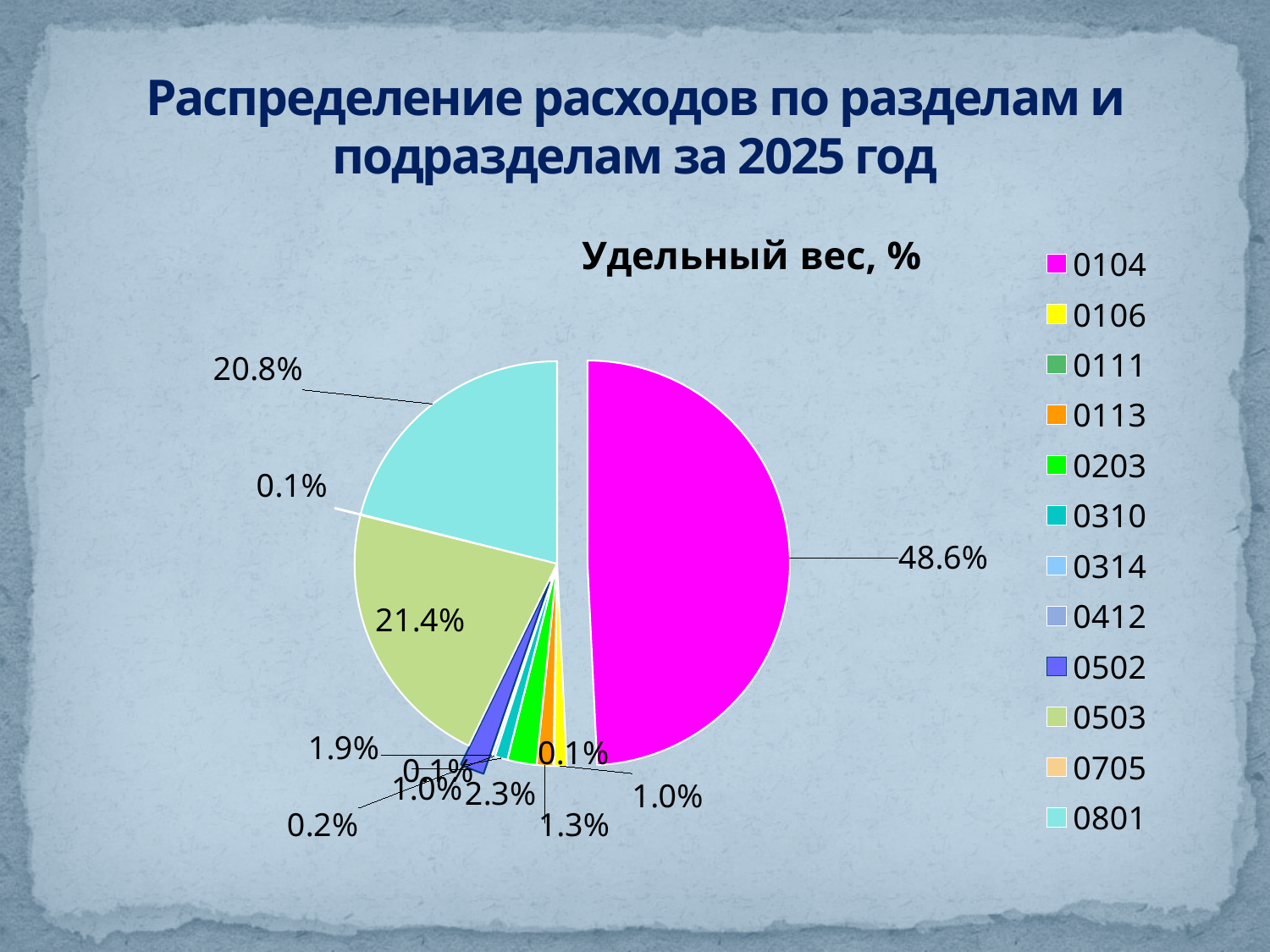
How many entries does the chart legend list? 12 What kind of chart is shown on the slide? pie chart What share of the pie does category 0104 have? 48.6% Which category has the largest slice of the pie? 0104 What is the difference between the shares of 0104 and 0503? 27.2% What share of the pie does category 0801 have? 20.8% What is the difference between the shares of 0503 and 0801? 0.6% Which is larger, the slice for 0503 or the slice for 0801? 0503 What share of the pie does category 0503 have? 21.4% What is the combined share of categories 0104, 0503 and 0801? 90.8% What colour is the slice for category 0104? magenta What is the title of the chart? Удельный вес, %